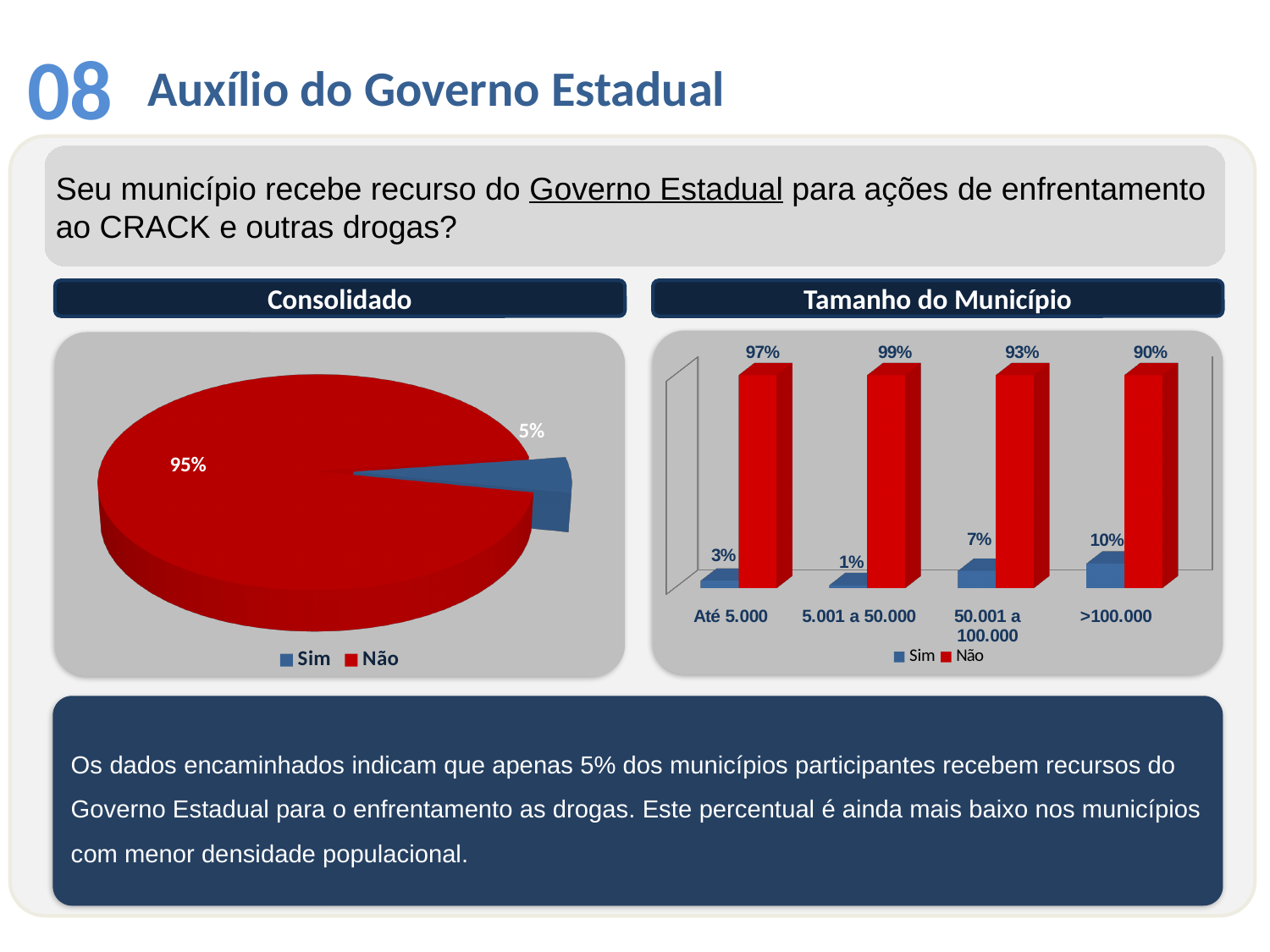
In the Tamanho do Município chart, what is the Não value for 5.001 a 50.000? 99% What kind of chart is the Tamanho do Município chart? bar chart What kind of chart is the Consolidado chart? pie chart In the Tamanho do Município chart, what is the difference between the Não values for Até 5.000 and 50.001 a 100.000? 4% How many series does the legend of the Tamanho do Município chart list? 2 In the Tamanho do Município chart, is the Sim value for 50.001 a 100.000 larger or smaller than the Sim value for 5.001 a 50.000? larger In the Tamanho do Município chart, which category has the highest Sim value? >100.000 In the Tamanho do Município chart, what is the Sim value for >100.000? 10% In the Consolidado chart, what percentage is shown for Sim? 5% In the Consolidado chart, what percentage is shown for Não? 95% How many categories are shown on the x axis of the Tamanho do Município chart? 4 In the Tamanho do Município chart, which category has the lowest Não value? >100.000